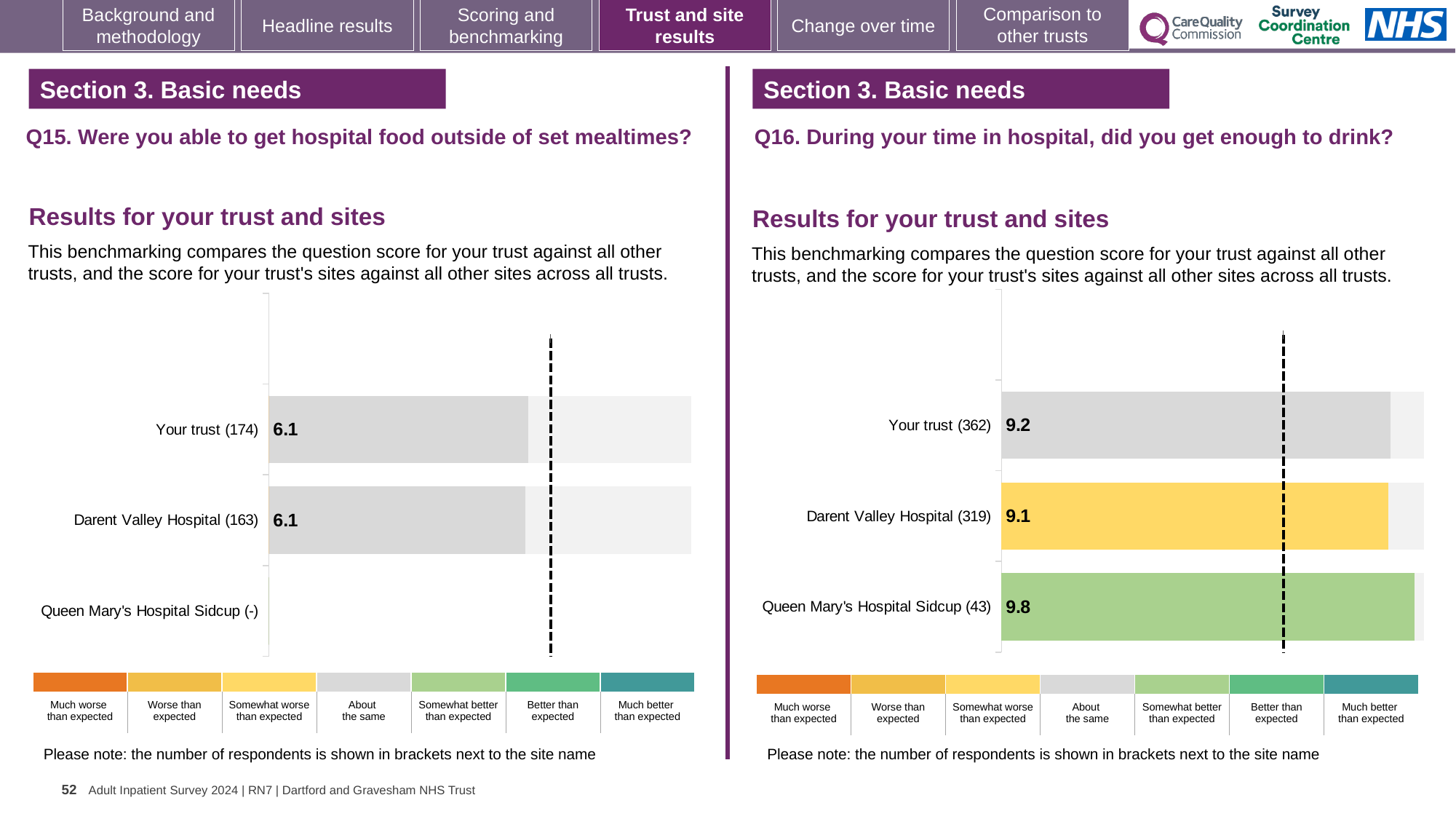
In the Q16 chart on the right, which site or trust has the highest score? Queen Mary's Hospital Sidcup (43) In the Q16 chart on the right, which site or trust has the lowest score? Darent Valley Hospital (319) What type of chart is used in the Q16 chart on the right? Bar chart In the Q15 chart on the left, what is the score for Darent Valley Hospital (163)? 6.1 In the Q16 chart on the right, what is the score for Queen Mary's Hospital Sidcup (43)? 9.8 In the Q16 chart on the right, which has the larger score: Your trust (362) or Darent Valley Hospital (319)? Your trust (362) In the Q16 chart on the right, what is the score for Your trust (362)? 9.2 In the Q15 chart on the left, how many respondents are shown in brackets for Darent Valley Hospital? 163 In the Q16 chart on the right, what is the difference between the scores for Queen Mary's Hospital Sidcup (43) and Darent Valley Hospital (319)? 0.7 In the Q16 chart on the right, which benchmark category does the colour of the Queen Mary's Hospital Sidcup (43) bar correspond to? Somewhat better than expected In the Q15 chart on the left, how many categories are listed on the vertical axis? 3 In the Q15 chart on the left, what is the score for Your trust (174)? 6.1